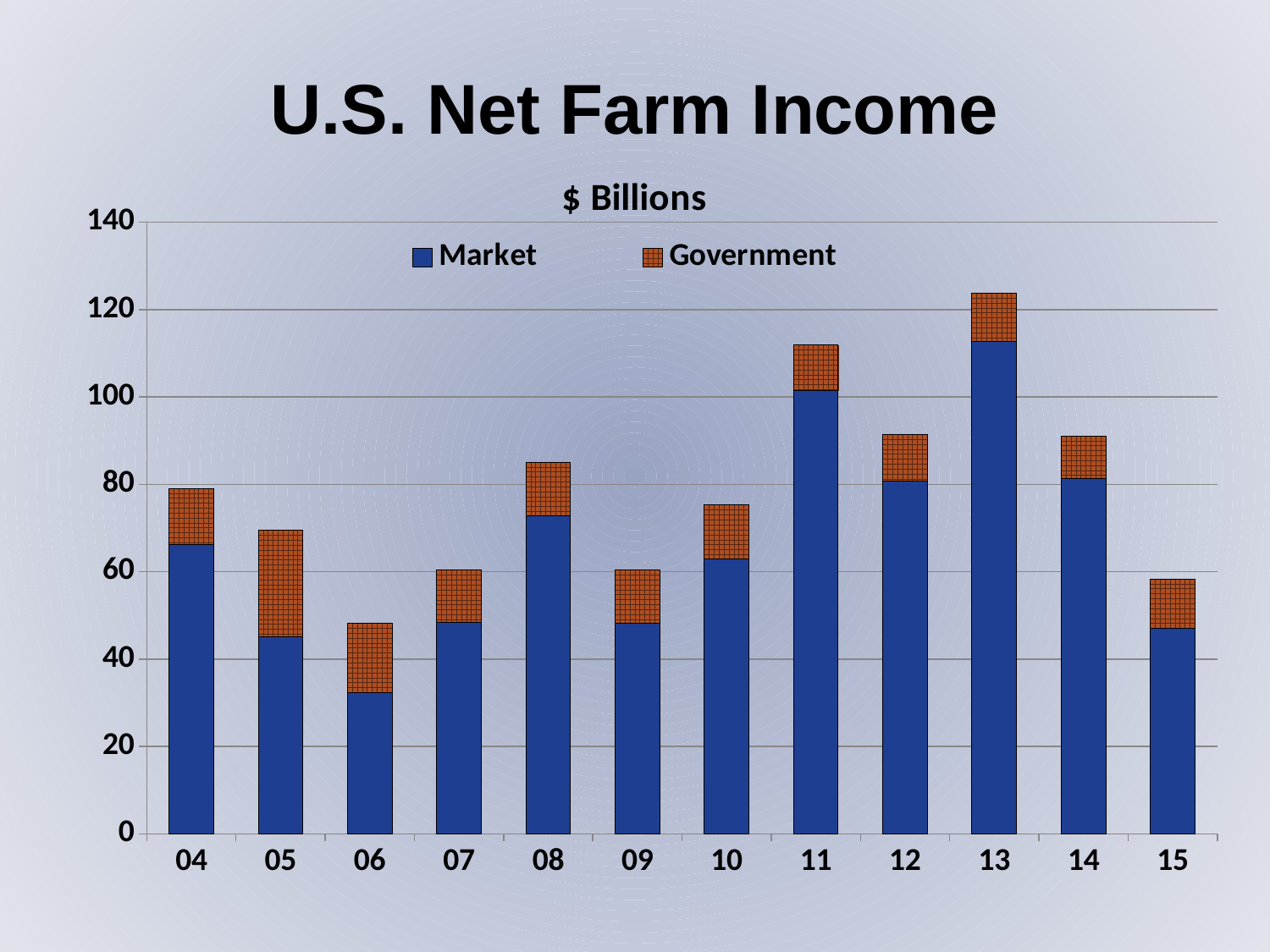
Which year has the larger total, 11 or 12? 11 Which year has the highest total net farm income? 13 Which year has the lowest total net farm income? 06 What kind of chart is shown on the slide? bar chart Is the Market value for 13 greater or less than 100? greater Which year has the lowest Market value? 06 How many series does the legend list? 2 How many years are shown on the x axis? 12 Is the total value for 06 greater or less than 60? less Is the total value for 11 greater or less than 100? greater Do the total values rise or fall from 13 to 15? fall What unit is given in the chart's subtitle? $ Billions